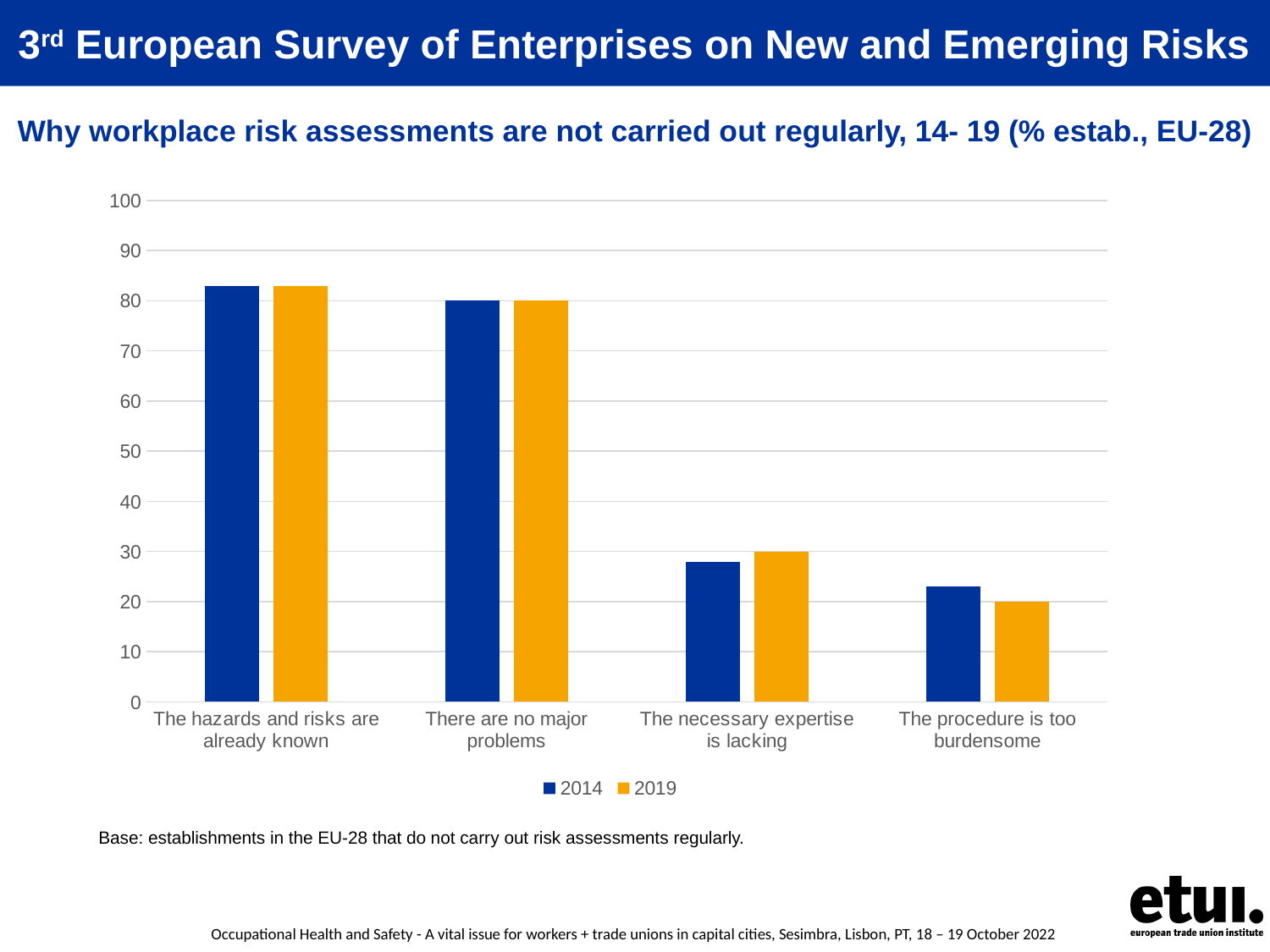
What kind of chart is shown on the slide? bar chart How many series does the legend list? 2 Is the 2014 value for 'The hazards and risks are already known' greater or less than 80? greater Is the 2019 value for 'There are no major problems' greater or less than 90? less Is the 2014 value for 'The procedure is too burdensome' greater or less than 20? greater Which colour represents the 2019 series in the chart? orange For 'The necessary expertise is lacking', which year has the larger value, 2014 or 2019? 2019 For 'The procedure is too burdensome', which year has the larger value, 2014 or 2019? 2014 How many categories are shown on the x axis? 4 Which category has the lowest value for 2019? The procedure is too burdensome Which category has the highest value for 2019? The hazards and risks are already known